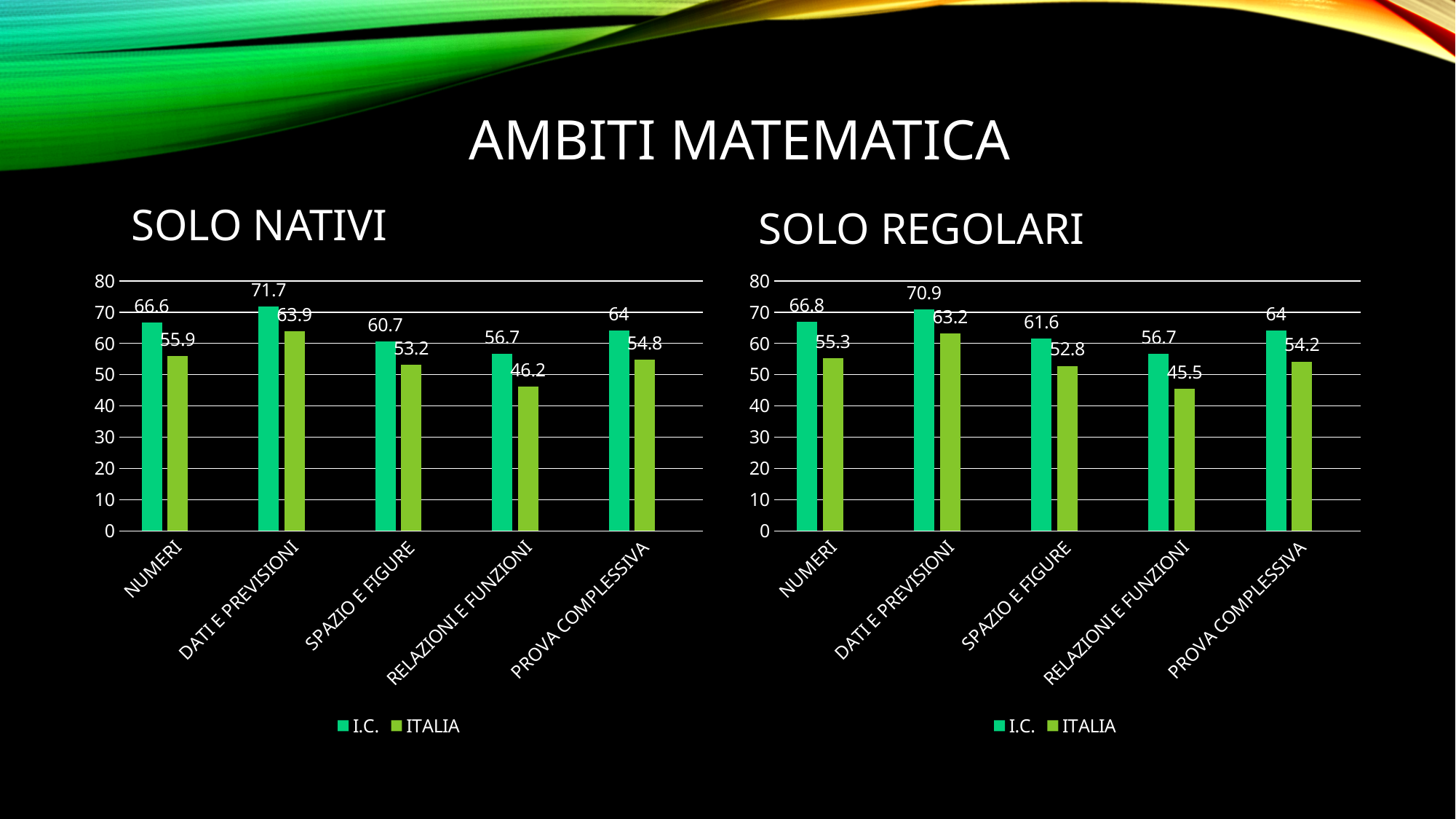
What is the title of the chart on the right side of the slide? SOLO REGOLARI In the SOLO NATIVI chart, what is the I.C. value for NUMERI? 66.6 In the SOLO NATIVI chart, what is the difference between the I.C. and ITALIA values for RELAZIONI E FUNZIONI? 10.5 In the SOLO REGOLARI chart, what is the ITALIA value for RELAZIONI E FUNZIONI? 45.5 What type of chart is the SOLO NATIVI chart? Bar chart In the SOLO NATIVI chart, which category has the highest I.C. value? DATI E PREVISIONI How many categories are shown on the x axis of the SOLO NATIVI chart? 5 In the SOLO NATIVI chart, which is larger for SPAZIO E FIGURE: the I.C. value or the ITALIA value? I.C. How many series does the legend of the SOLO REGOLARI chart list? 2 In the SOLO REGOLARI chart, is the ITALIA value for NUMERI greater or less than 60? less In the SOLO REGOLARI chart, which category has the lowest ITALIA value? RELAZIONI E FUNZIONI In the SOLO REGOLARI chart, what is the difference between the I.C. and ITALIA values for DATI E PREVISIONI? 7.7